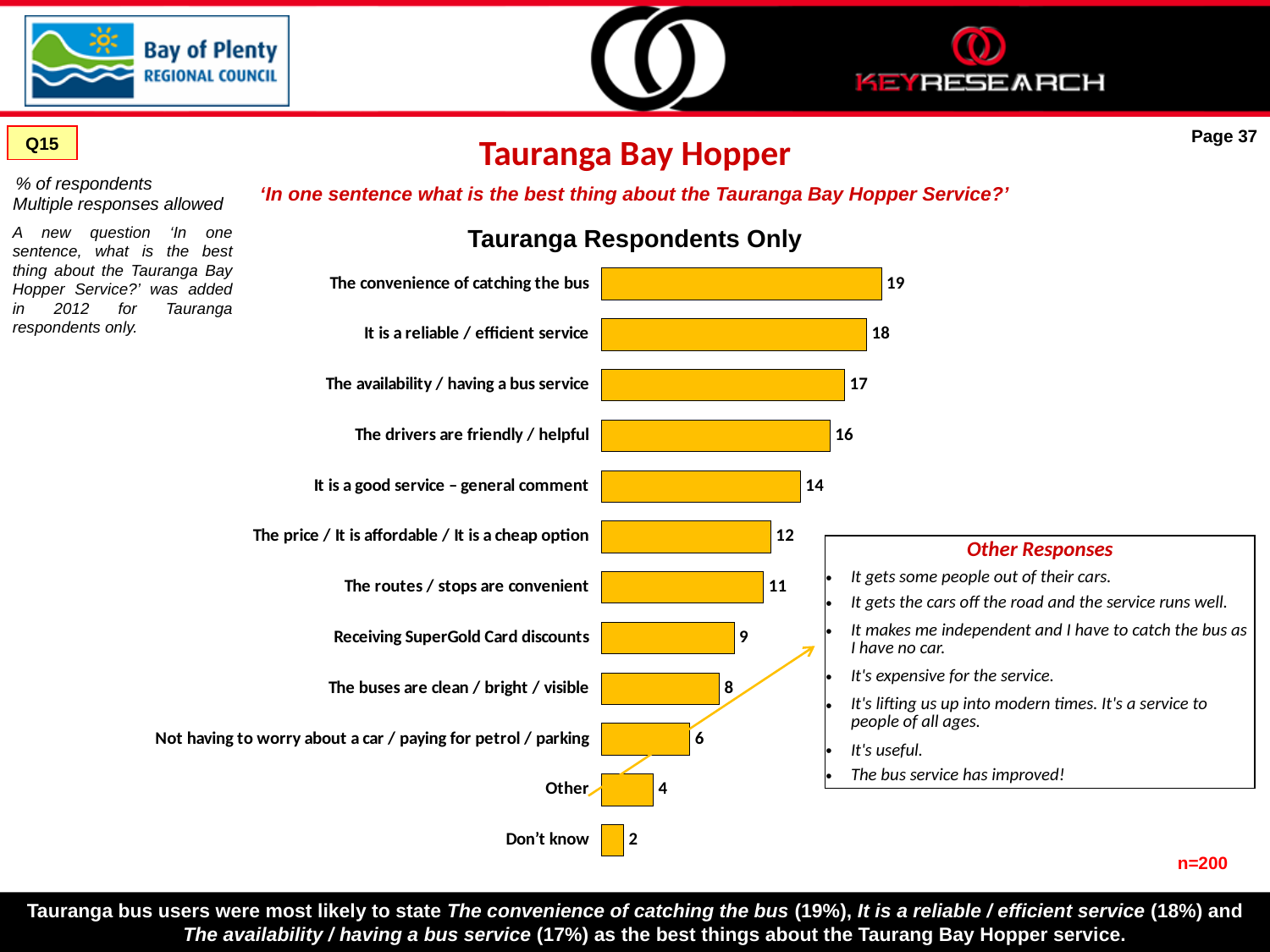
What is the value for 'The convenience of catching the bus'? 19 What is the value for 'Don't know'? 2 Which category has the highest value? The convenience of catching the bus What is the value for 'Receiving SuperGold Card discounts'? 9 How many categories are shown in the chart? 12 What is the difference between 'It is a reliable / efficient service' and 'The routes / stops are convenient'? 7 What is the value for 'Other'? 4 What is the difference between 'The buses are clean / bright / visible' and 'Not having to worry about a car / paying for petrol / parking'? 2 Which category has the lowest value? Don't know Which is larger: 'The drivers are friendly / helpful' or 'The price / It is affordable / It is a cheap option'? The drivers are friendly / helpful What is the title of the chart? Tauranga Respondents Only What kind of chart is shown on the slide? Bar chart